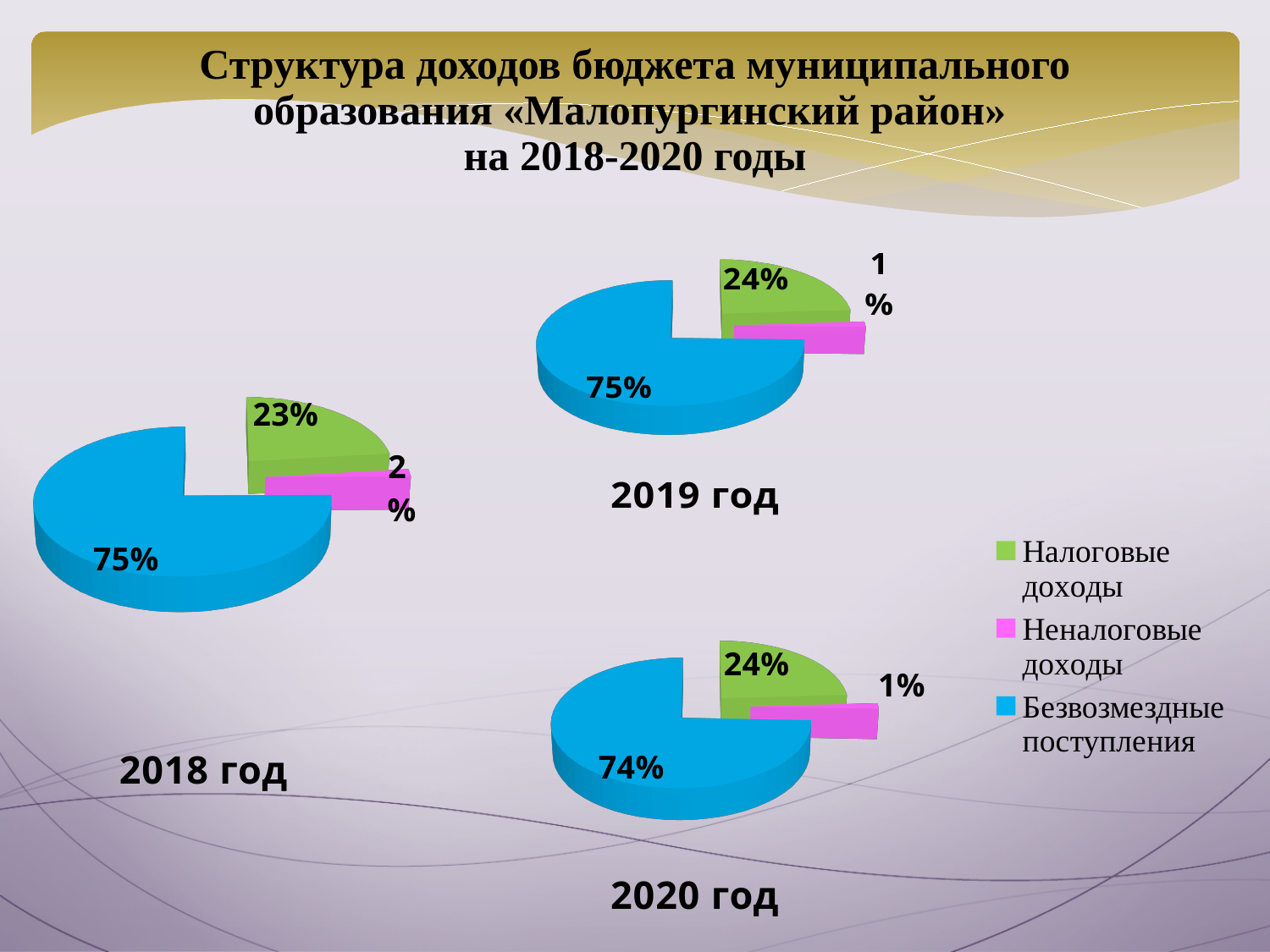
In the 2018 год chart, what share is Неналоговые доходы? 2% In the 2019 год chart, what share is Неналоговые доходы? 1% In the 2019 год chart, what share is Налоговые доходы? 24% In the 2019 год chart, which category has the smallest share? Неналоговые доходы Which colour represents Неналоговые доходы in the legend? Pink What kind of charts are shown on the slide? Pie charts How many categories does the legend list? 3 In the 2018 год chart, what share is Налоговые доходы? 23% In the 2020 год chart, what share is Безвозмездные поступления? 74% In the 2020 год chart, which category has the largest share? Безвозмездные поступления In the 2018 год chart, what share is Безвозмездные поступления? 75% In the 2018 год chart, what is the difference between the shares of Безвозмездные поступления and Налоговые доходы? 52%